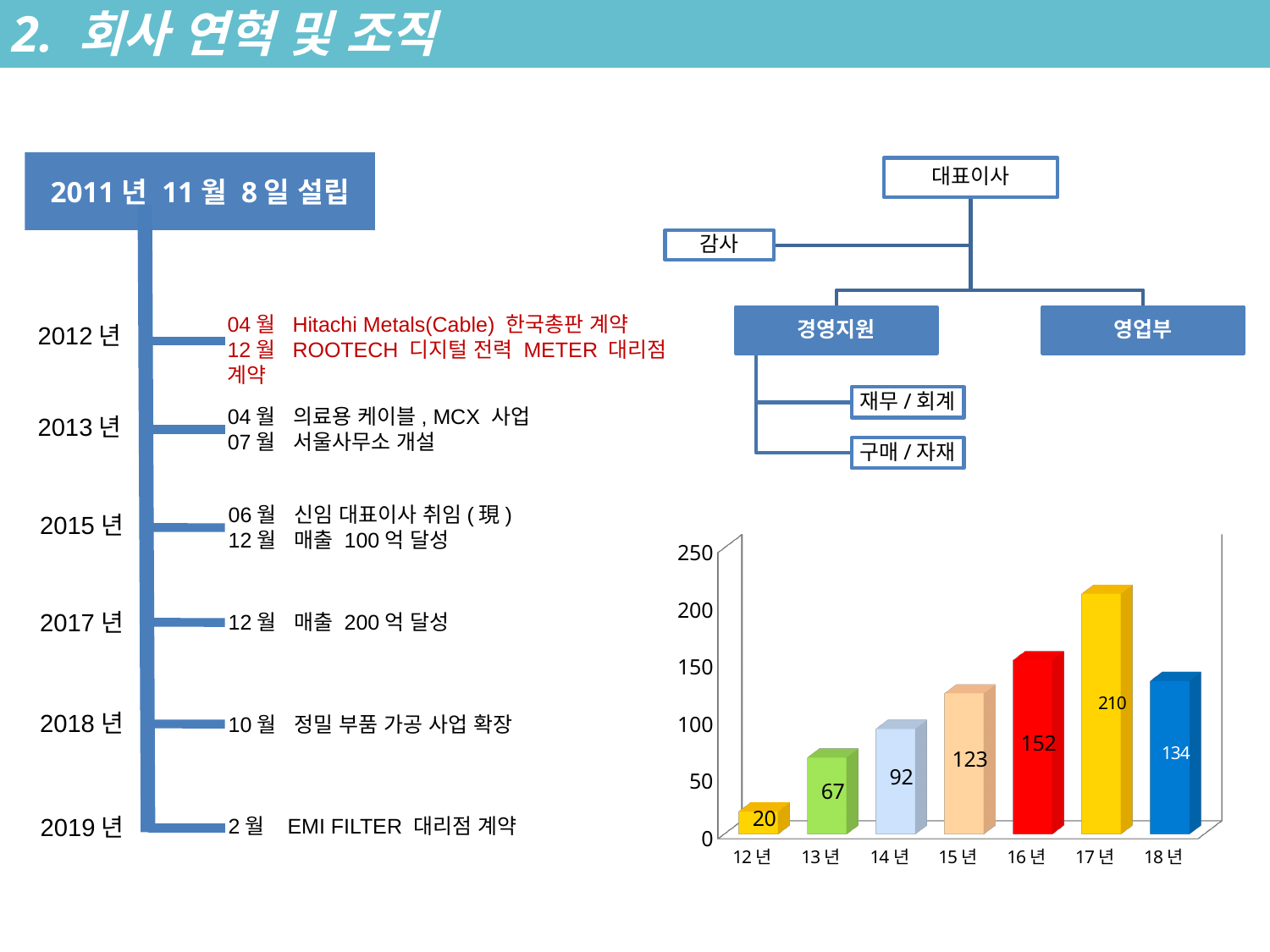
What is the value for 15년 in the bar chart? 123 How many years (categories) are shown on the x axis of the bar chart? 7 What kind of chart is shown at the bottom right of the slide? bar chart What is the value for 18년 in the bar chart? 134 What is the value for 12년 in the bar chart? 20 Which year has the lowest value in the bar chart? 12년 What is the difference between the values for 17년 and 18년? 76 What is the difference between the values for 16년 and 15년? 29 Do the values rise or fall from 12년 to 17년 in the bar chart? rise Is the value for 16년 greater or less than 150? greater Which is larger, the value for 14년 or the value for 18년? 18년 Which year has the highest value in the bar chart? 17년